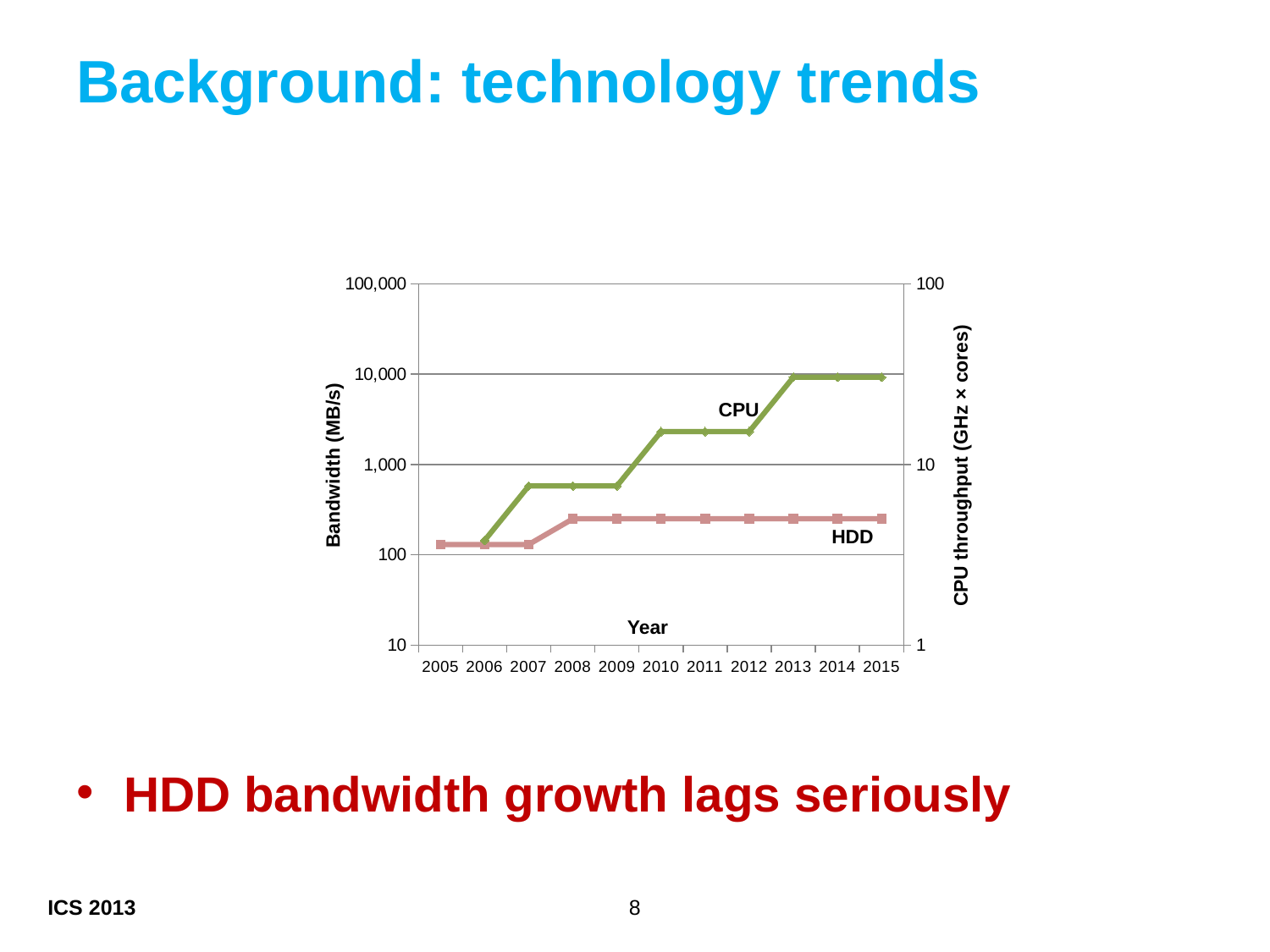
Is the HDD bandwidth value for 2015 greater or less than 100 MB/s? greater How many data series are plotted in the chart? 2 Is the HDD bandwidth value for 2005 greater or less than 1,000 MB/s? less Which series is labelled with the pink line with square markers? HDD Is the HDD bandwidth value for 2010 greater or less than 1,000 MB/s? less What is the title of the right vertical axis? CPU throughput (GHz × cores) What is the title of the left vertical axis? Bandwidth (MB/s) What kind of chart is shown on the slide? line chart How many years are shown along the x axis of the chart? 11 Does the CPU line rise or fall overall from 2005 to 2015? rise